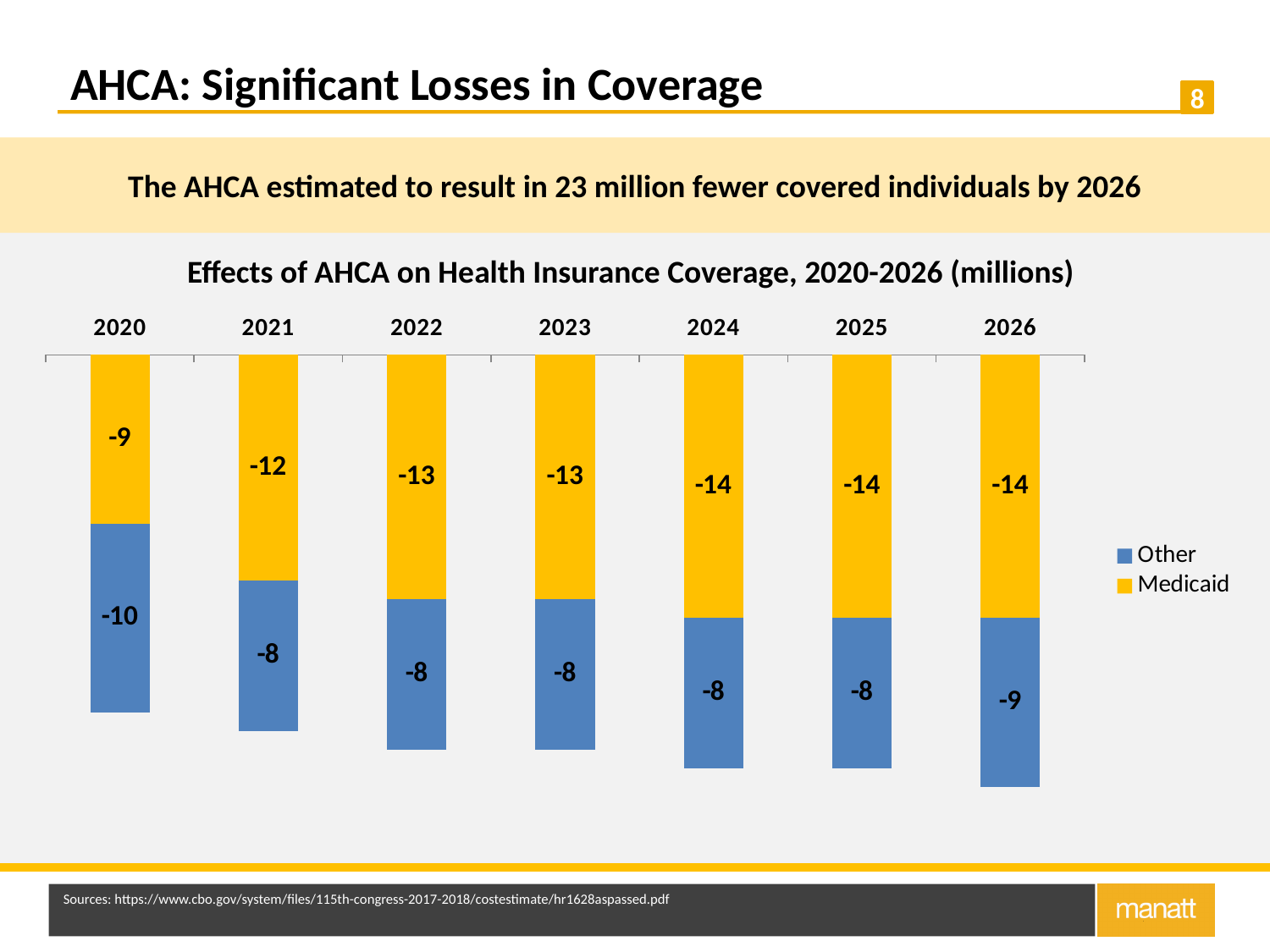
What kind of chart is shown? Stacked bar chart What is the Medicaid value for 2024? -14 What is the difference between the Medicaid values for 2020 and 2026? 5 Which year has the smallest Medicaid loss (value closest to zero)? 2020 What is the total of the stacked bar for 2020? -19 How many series does the legend list? 2 What is the Other value for 2026? -9 What is the title of the chart? Effects of AHCA on Health Insurance Coverage, 2020-2026 (millions) What is the Other value for 2021? -8 What is the Medicaid value for 2020? -9 How many years are shown on the x axis? 7 What is the total of the stacked bar for 2026? -23